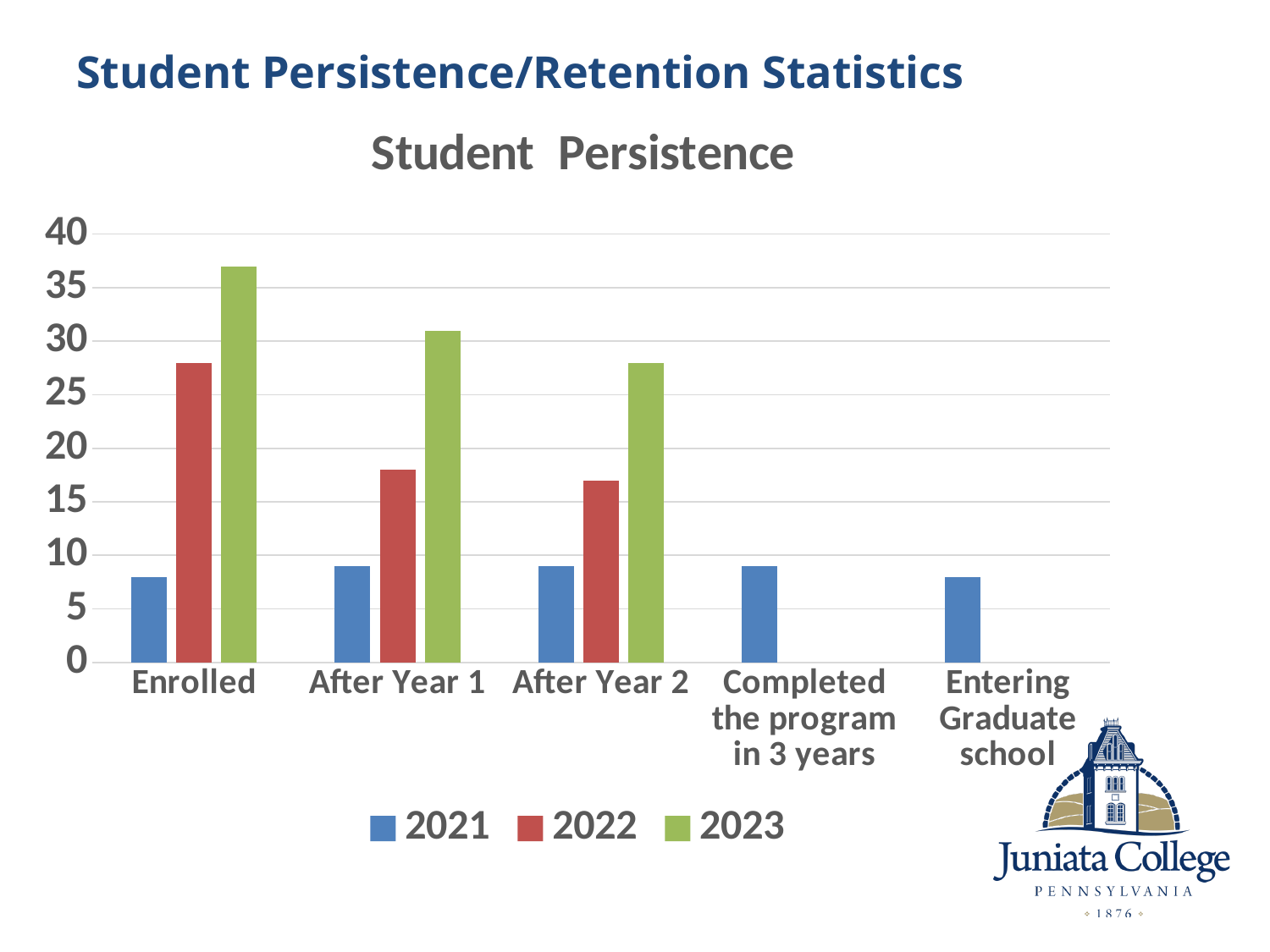
Is the 2022 value for After Year 2 greater or less than 20? less Which series has the highest value for Enrolled? 2023 Which is larger: the 2022 value for Enrolled or the 2022 value for After Year 1? Enrolled Is the 2023 value for Enrolled greater or less than 35? greater Which category has the highest 2023 value? Enrolled How many categories are shown on the x axis? 5 Is the 2021 value for Completed the program in 3 years greater or less than 10? less How many series does the legend list? 3 Which series has the lowest value for After Year 1? 2021 Do the 2023 values rise or fall from Enrolled to After Year 2? fall What kind of chart is shown on the slide? bar chart What is the title of the chart? Student Persistence